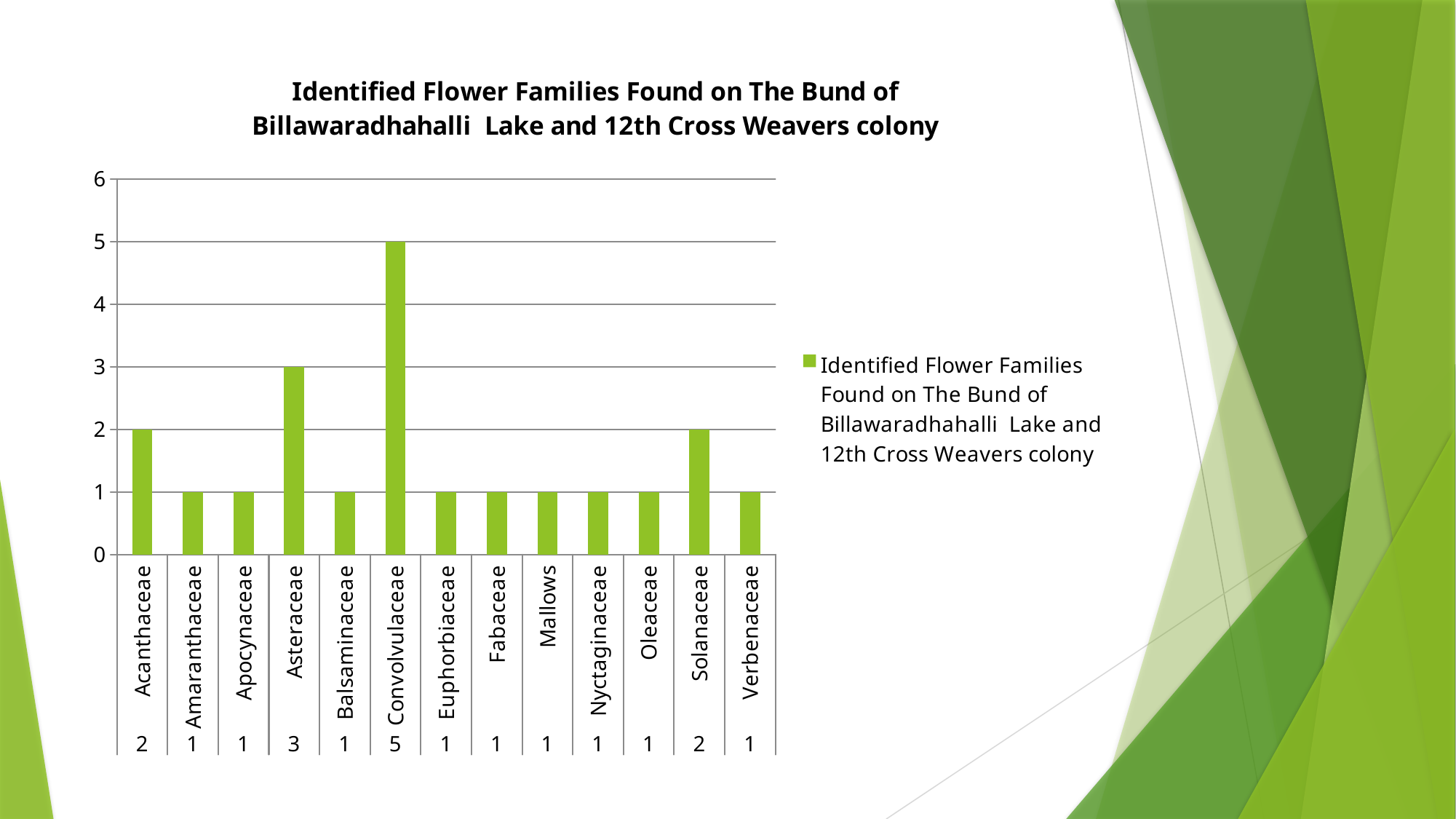
What is the value for Convolvulaceae? 5 How many flower families have a value of 1? 9 What is the difference between the values for Convolvulaceae and Asteraceae? 2 Is the value for Convolvulaceae greater or less than 4? greater What is the value for Solanaceae? 2 How many series does the legend list? 1 What colour are the bars in the chart? green How many flower families are shown on the x axis? 13 Which has a larger value, Acanthaceae or Asteraceae? Asteraceae Which flower family has the highest value? Convolvulaceae What is the value for Asteraceae? 3 What kind of chart is shown on the slide? bar chart